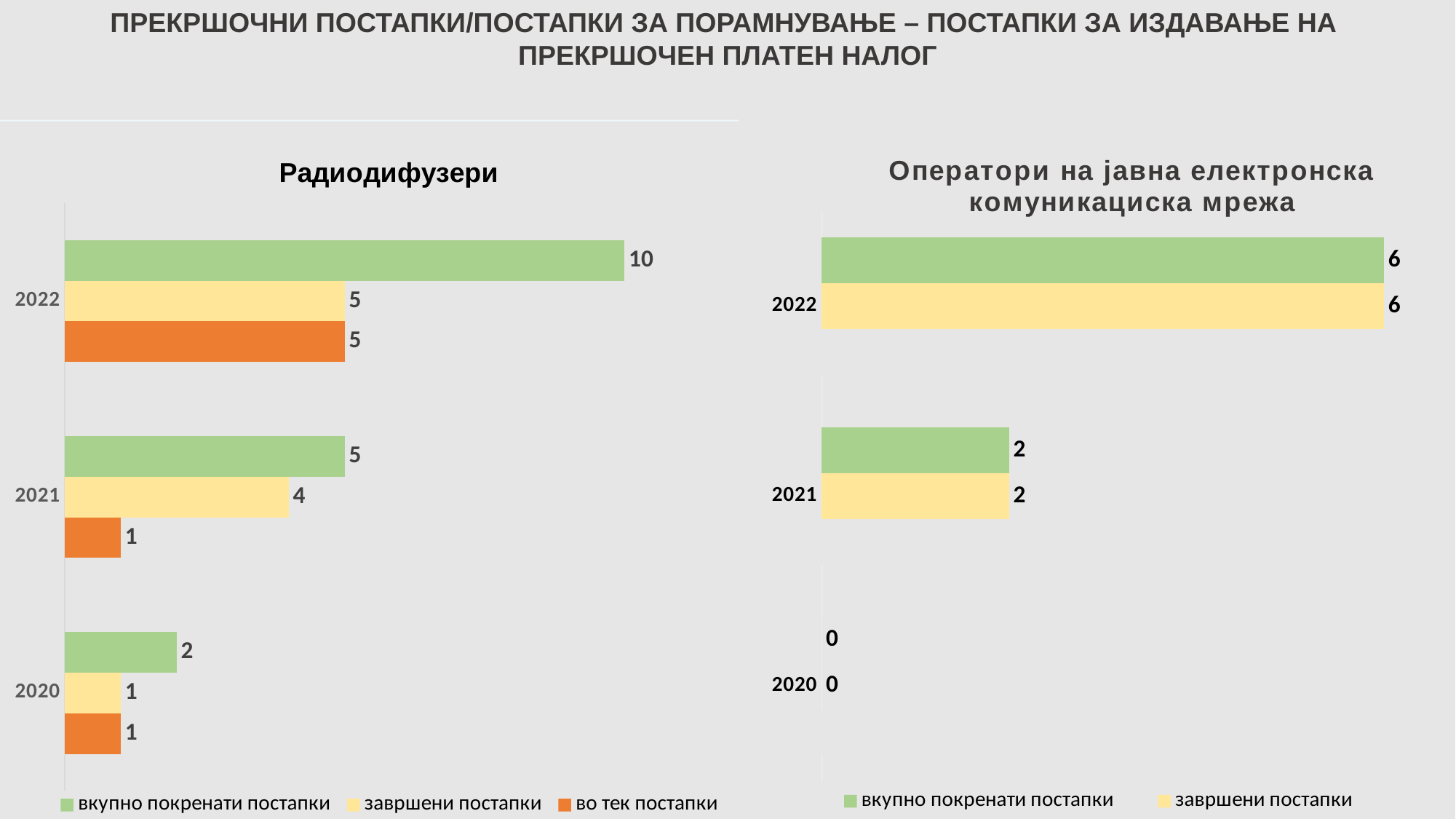
What type of chart is the 'Радиодифузери' chart? Bar chart In the 'Радиодифузери' chart, which year has the highest value for 'вкупно покренати постапки'? 2022 In the 'Радиодифузери' chart, what is the difference between 'вкупно покренати постапки' and 'завршени постапки' in 2022? 5 In the 'Радиодифузери' chart, which year has the lowest value for 'завршени постапки'? 2020 In the 'Оператори на јавна електронска комуникациска мрежа' chart, what is the difference in 'вкупно покренати постапки' between 2022 and 2021? 4 How many series does the legend of the 'Радиодифузери' chart list? 3 In the 'Радиодифузери' chart, what is the value of 'во тек постапки' for 2021? 1 In the 'Радиодифузери' chart, what is the value of 'вкупно покренати постапки' for 2022? 10 In the 'Радиодифузери' chart, which is larger: 'завршени постапки' in 2021 or 'во тек постапки' in 2021? завршени постапки In the 'Оператори на јавна електронска комуникациска мрежа' chart, what is the value of 'вкупно покренати постапки' for 2020? 0 How many series does the legend of the 'Оператори на јавна електронска комуникациска мрежа' chart list? 2 In the 'Оператори на јавна електронска комуникациска мрежа' chart, what is the value of 'завршени постапки' for 2022? 6